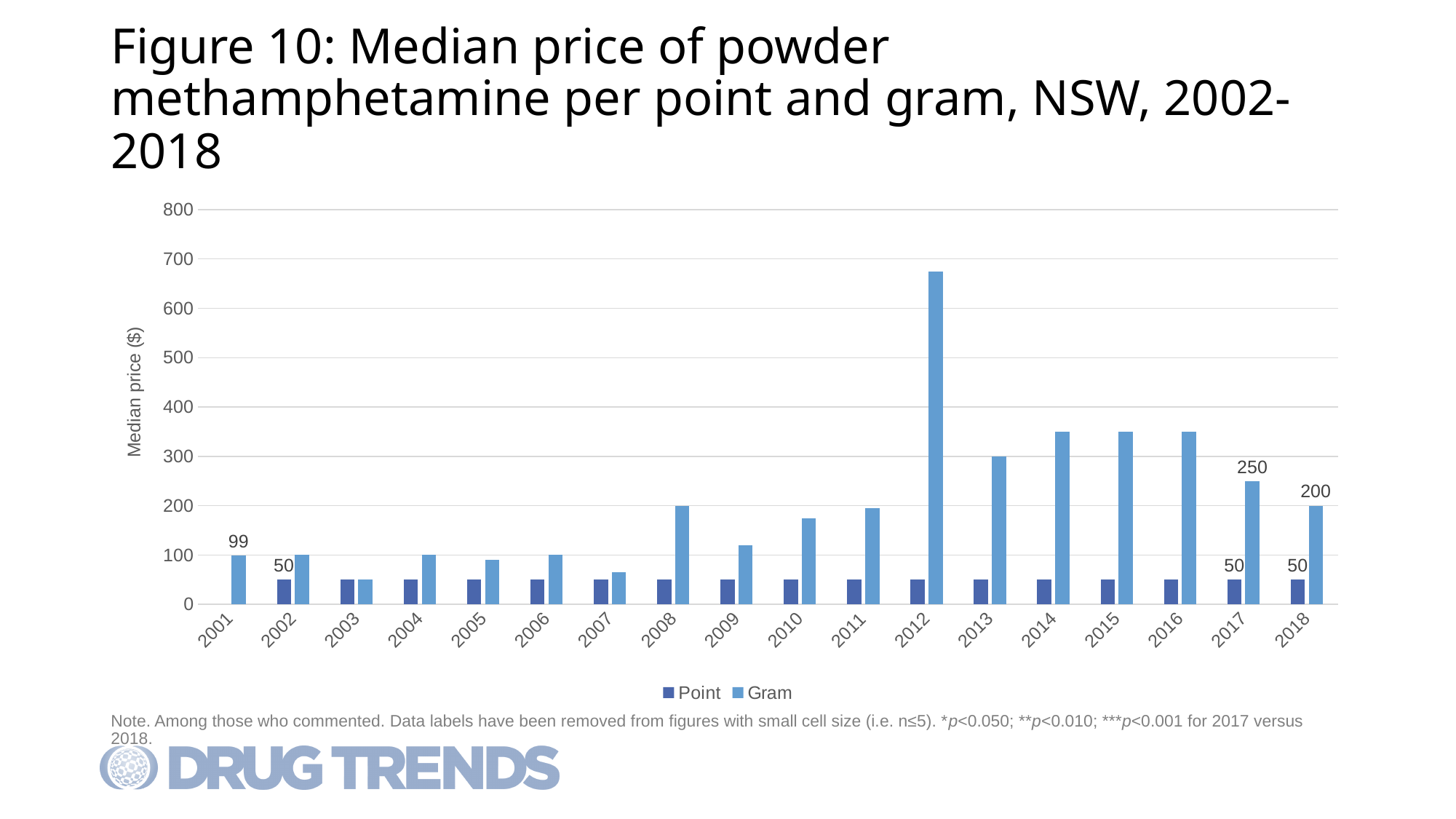
What is the difference between the median price per gram in 2017 and in 2018? 50 Is the median price per gram in 2012 greater or less than 600? greater How many years are shown on the x axis? 18 What is the median price per gram in 2017? 250 What is the median price per gram in 2018? 200 What is the difference between the median price per gram and per point in 2017? 200 How many series does the legend list? 2 What is the median price per point in 2018? 50 What is the median price per gram in 2001? 99 Is the median price per gram in 2014 greater or less than 300? greater In which year is the median price per gram highest? 2012 Which is larger, the median price per gram in 2012 or in 2013? 2012